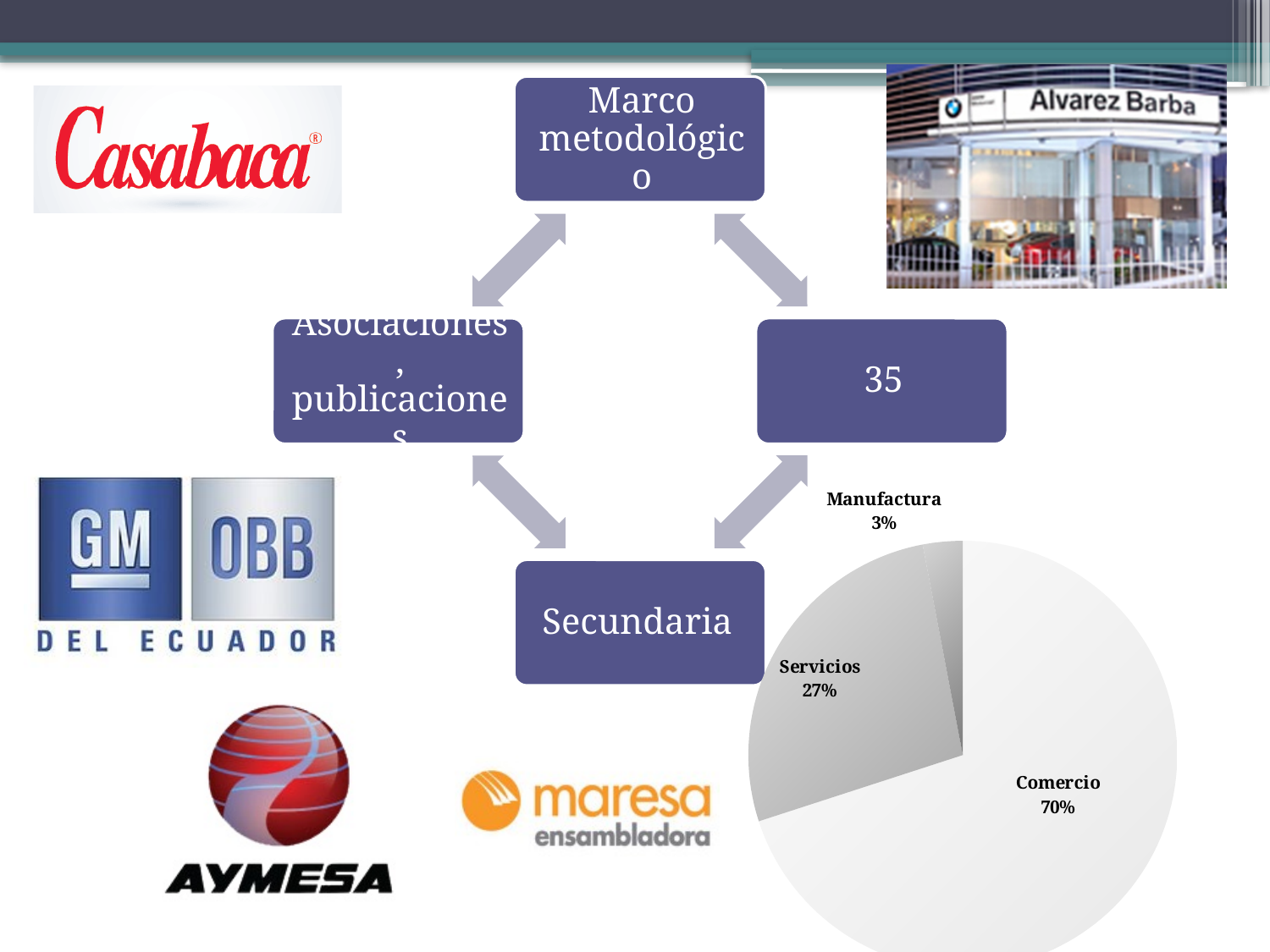
Which is larger in the pie chart, Comercio or Servicios? Comercio How many slices does the pie chart have? 3 What share of the pie does Manufactura represent? 3% What kind of chart is shown on the slide? pie chart What is the difference in percentage points between Servicios and Manufactura? 24 What is the difference in percentage points between Comercio and Servicios? 43 What share of the pie does Servicios represent? 27% What share of the pie does Comercio represent? 70% Which category has the smallest slice of the pie chart? Manufactura Which is larger in the pie chart, Servicios or Manufactura? Servicios Which category has the largest slice of the pie chart? Comercio What are the three categories labelled on the pie chart? Comercio, Servicios, Manufactura